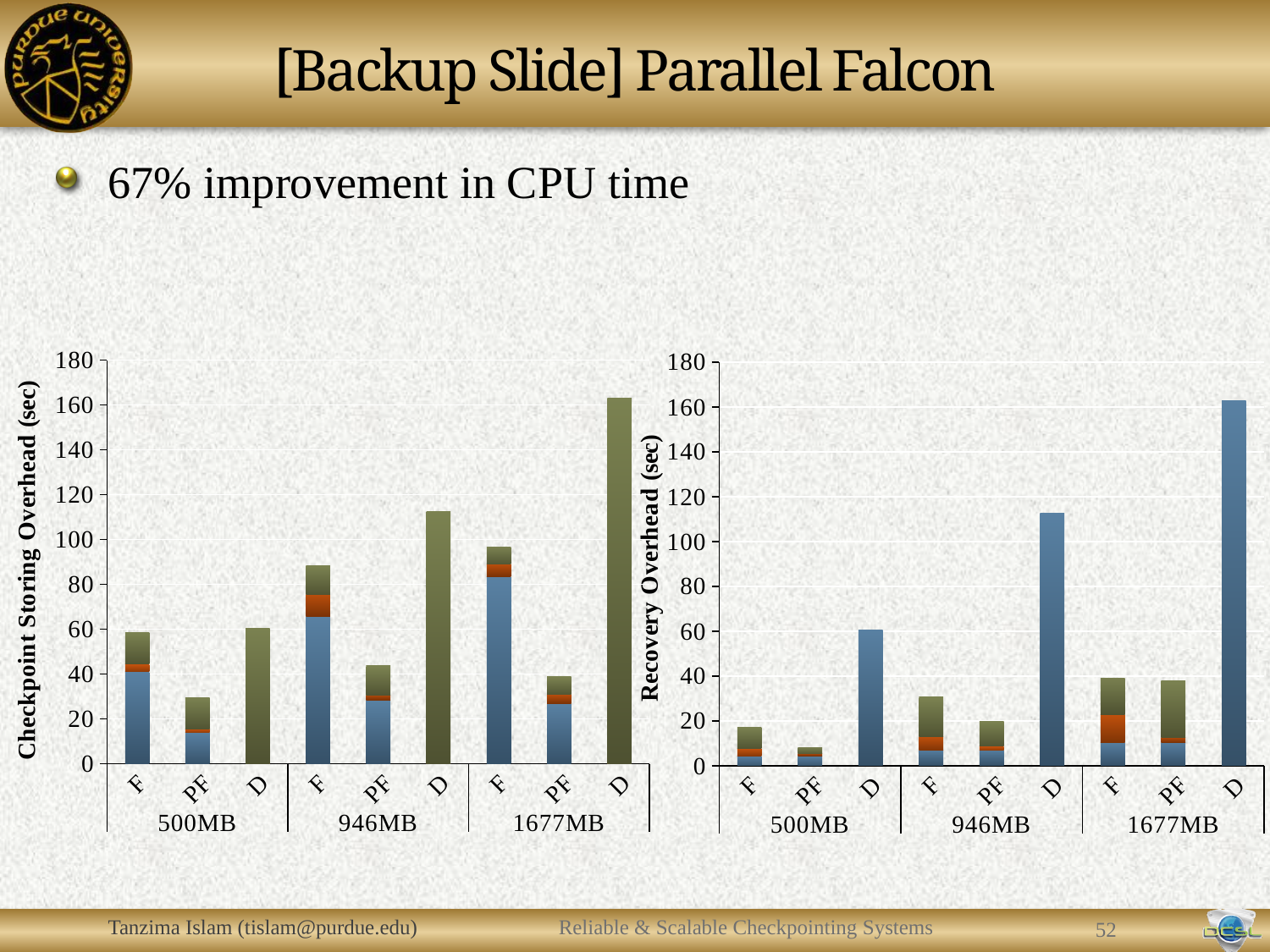
In the left chart (Checkpoint Storing Overhead), is the value for D at 946MB greater or less than 100? greater In the left chart (Checkpoint Storing Overhead), which is larger at 500MB: F or PF? F In the right chart (Recovery Overhead), is the value for F at 500MB greater or less than 20? less In the left chart (Checkpoint Storing Overhead), do the D bars rise or fall as the size goes from 500MB to 1677MB? rise How many bars are plotted in the right chart, Recovery Overhead (sec)? 9 What is the y-axis title of the right chart? Recovery Overhead (sec) In the right chart (Recovery Overhead), which is larger at 1677MB: F or D? D What are the three size groups shown on the x axis of the left chart? 500MB, 946MB, 1677MB In the right chart (Recovery Overhead), which bar is the lowest? PF at 500MB In the right chart (Recovery Overhead), is the value for D at 1677MB greater or less than 160? greater What kind of chart is the left chart, titled Checkpoint Storing Overhead (sec)? stacked bar chart In the left chart (Checkpoint Storing Overhead), which bar is the highest? D at 1677MB